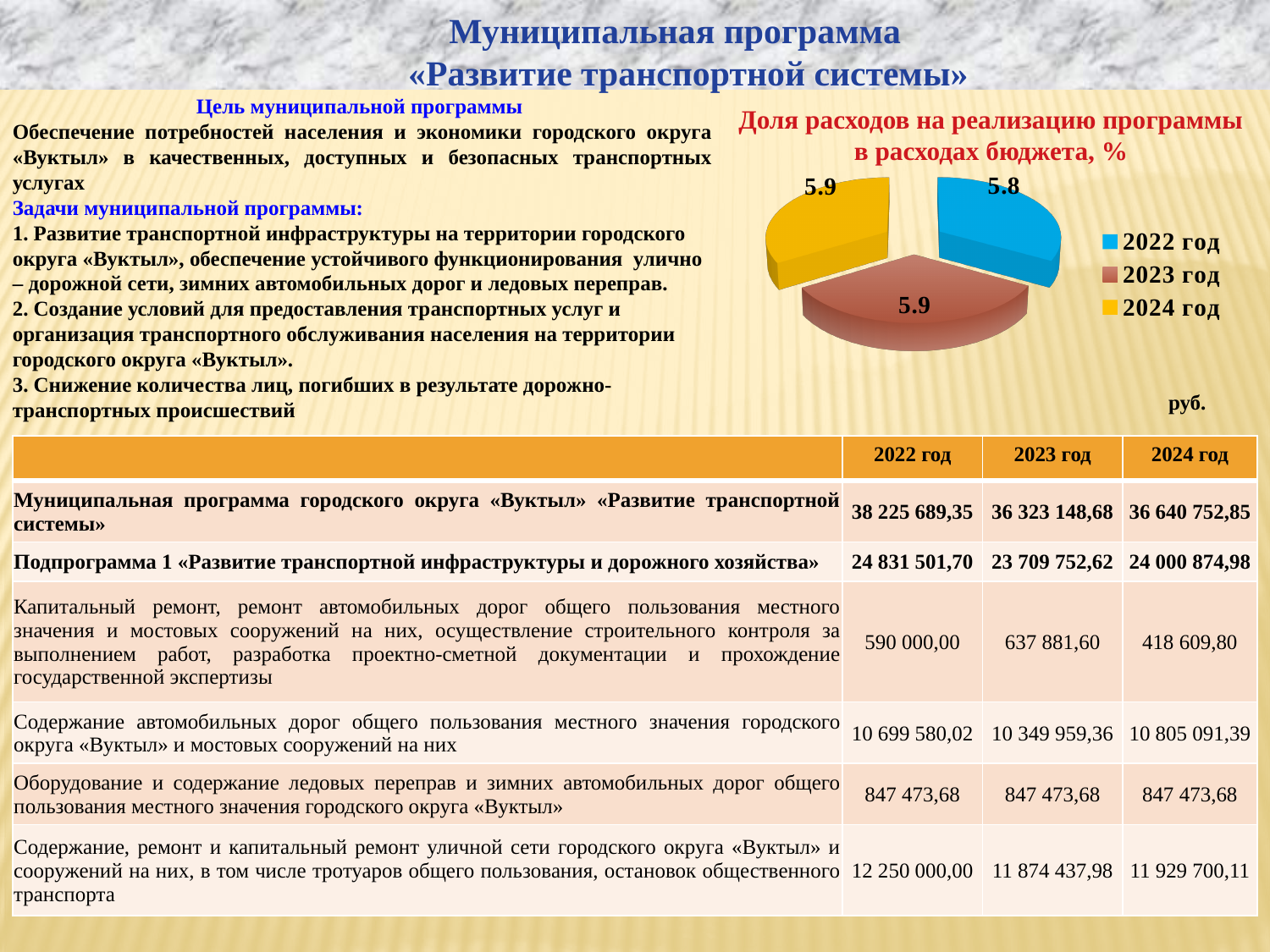
What is the difference between the values for 2023 год and 2022 год in the pie chart? 0.1 Which year has the lowest value in the pie chart? 2022 год What is the value shown for 2023 год in the pie chart? 5.9 Which is larger in the pie chart, the value for 2022 год or the value for 2023 год? 2023 год How many entries does the legend of the pie chart list? 3 What colour is the slice for 2024 год in the pie chart? yellow What is the value shown for 2022 год in the pie chart? 5.8 What is the title of the pie chart? Доля расходов на реализацию программы в расходах бюджета, % What type of chart is shown on the slide? pie chart How many slices does the pie chart have? 3 What is the value shown for 2024 год in the pie chart? 5.9